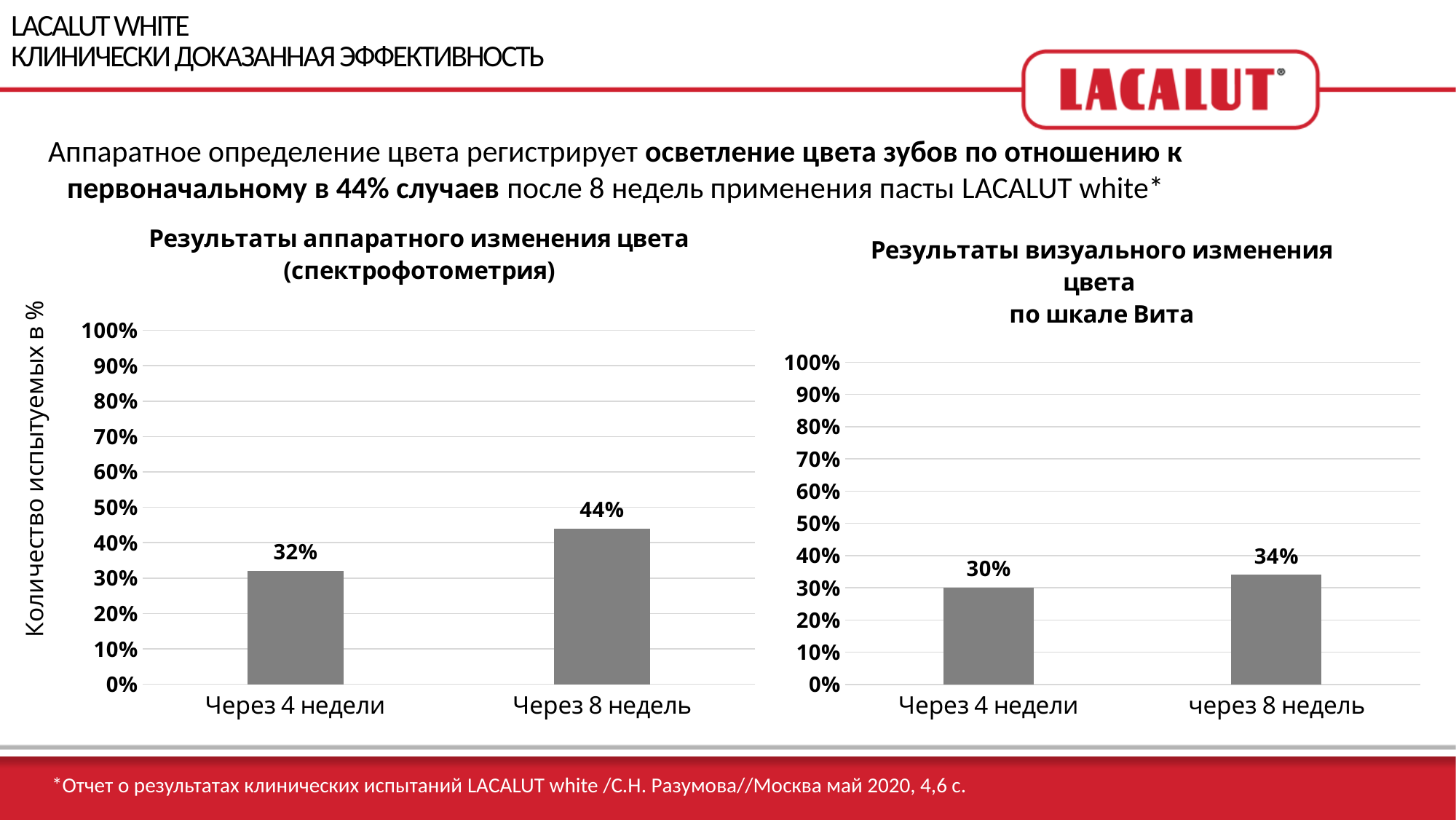
In the left chart (спектрофотометрия), which category has the highest value? Через 8 недель In the right chart (по шкале Вита), which category has the lowest value? Через 4 недели In the left chart (спектрофотометрия), is the value for Через 8 недель greater or less than 50%? less In the left chart (спектрофотометрия), what is the difference between the value for Через 8 недель and the value for Через 4 недели? 12% In the right chart (Результаты визуального изменения цвета по шкале Вита), what is the value for Через 4 недели? 30% In the left chart (Результаты аппаратного изменения цвета), what is the value for Через 8 недель? 44% What kind of chart is the left chart (спектрофотометрия)? bar chart How many categories are shown in the right chart (по шкале Вита)? 2 In the left chart (Результаты аппаратного изменения цвета), what is the value for Через 4 недели? 32% In the right chart (Результаты визуального изменения цвета по шкале Вита), what is the value for через 8 недель? 34% In the right chart (по шкале Вита), what is the difference between the value for через 8 недель and the value for Через 4 недели? 4% In the left chart (спектрофотометрия), do the values rise or fall from Через 4 недели to Через 8 недель? rise